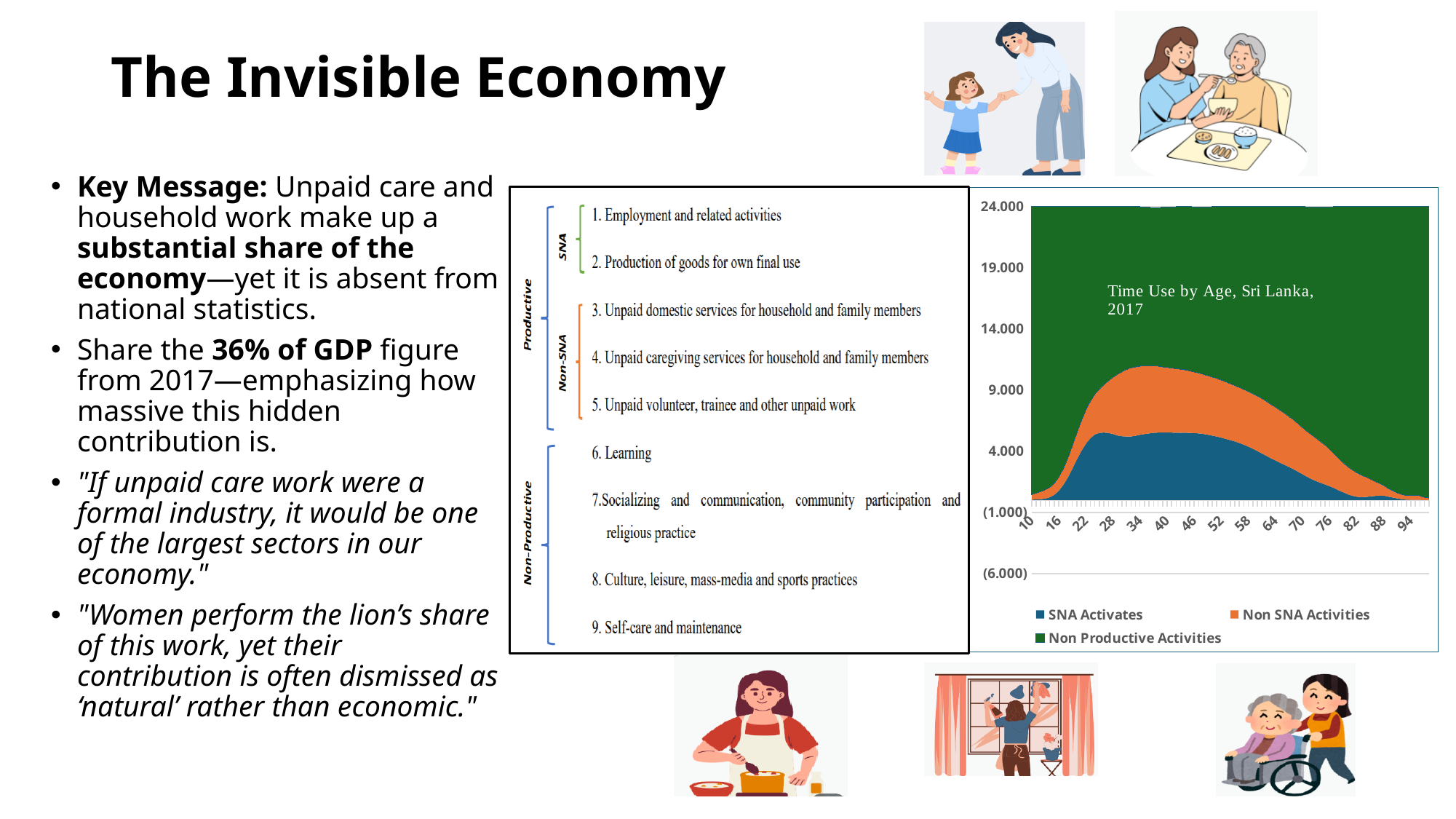
Which series in the Time Use by Age chart is shown in orange? Non SNA Activities In the Time Use by Age chart, which series occupies the largest area at age 94? Non Productive Activities What is the title of the chart on the right of the slide? Time Use by Age, Sri Lanka, 2017 In the Time Use by Age chart, does the SNA Activates area rise or fall between ages 52 and 88? fall In the Time Use by Age chart, is the value for SNA Activates at age 40 greater or less than 9.000? less What kind of chart is shown on the right of the slide? Stacked area chart What is the highest value labelled on the y axis of the Time Use by Age chart? 24.000 How many series does the legend of the Time Use by Age chart list? 3 In the Time Use by Age chart, is the value for SNA Activates at age 40 greater or less than 4.000? greater How many age labels are shown on the x axis of the Time Use by Age chart? 15 In the Time Use by Age chart, does the SNA Activates area rise or fall between ages 10 and 28? rise In the Time Use by Age chart, is the value for SNA Activates at age 10 greater or less than 4.000? less